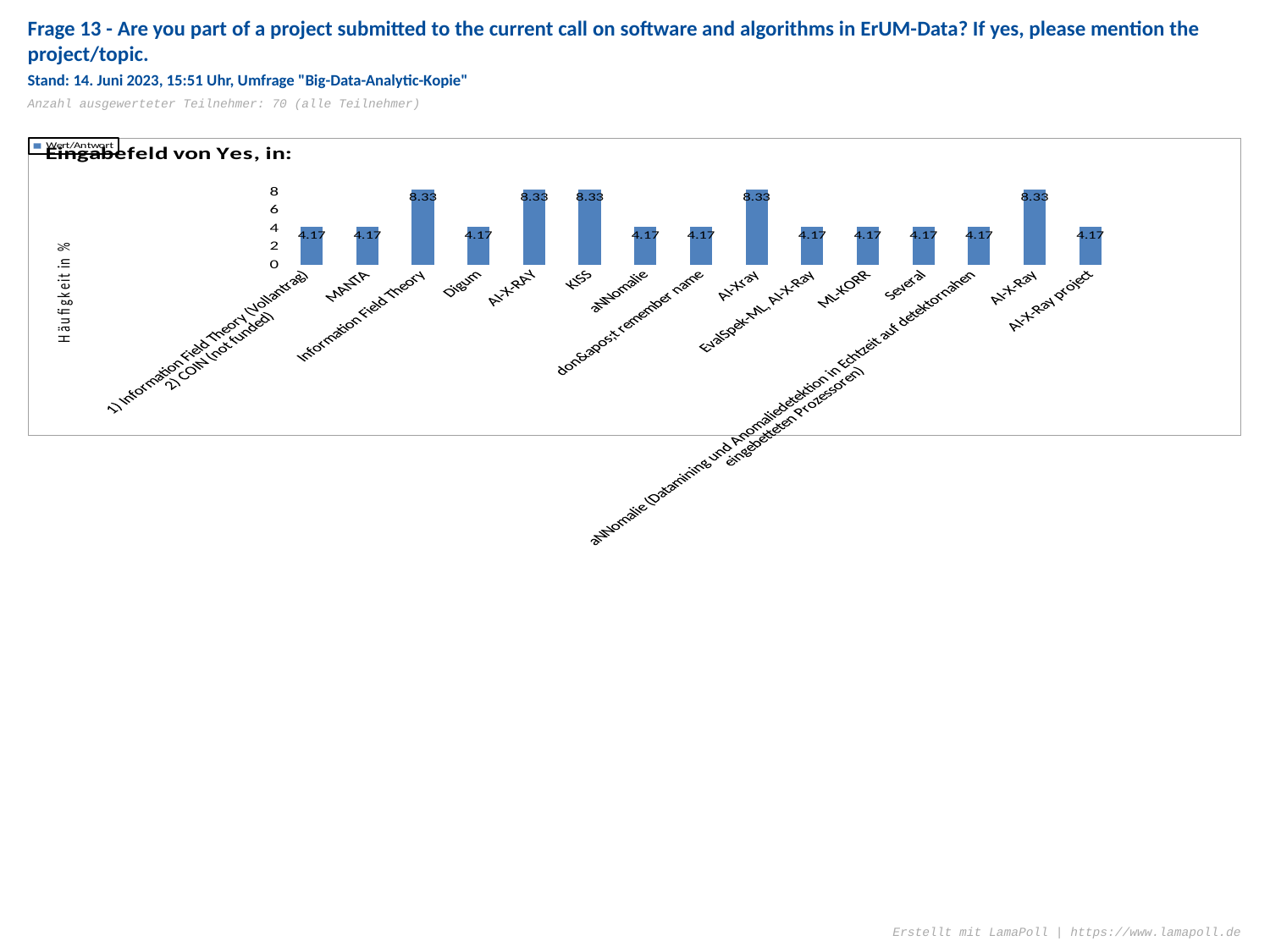
How many bars are shown in the chart? 15 What is the difference between the value for Information Field Theory and the value for Several? 4.16 What is the value for ML-KORR? 4.17 How many series does the legend list? 1 Which is larger, the value for Digum or the value for KISS? KISS What kind of chart is shown on the slide? bar chart What is the value for KISS? 8.33 What is the value for Information Field Theory? 8.33 What is the value for MANTA? 4.17 What is the value for AI-X-Ray project? 4.17 Is the value for Digum greater or less than 6? less What is the label of the y axis? Häufigkeit in %